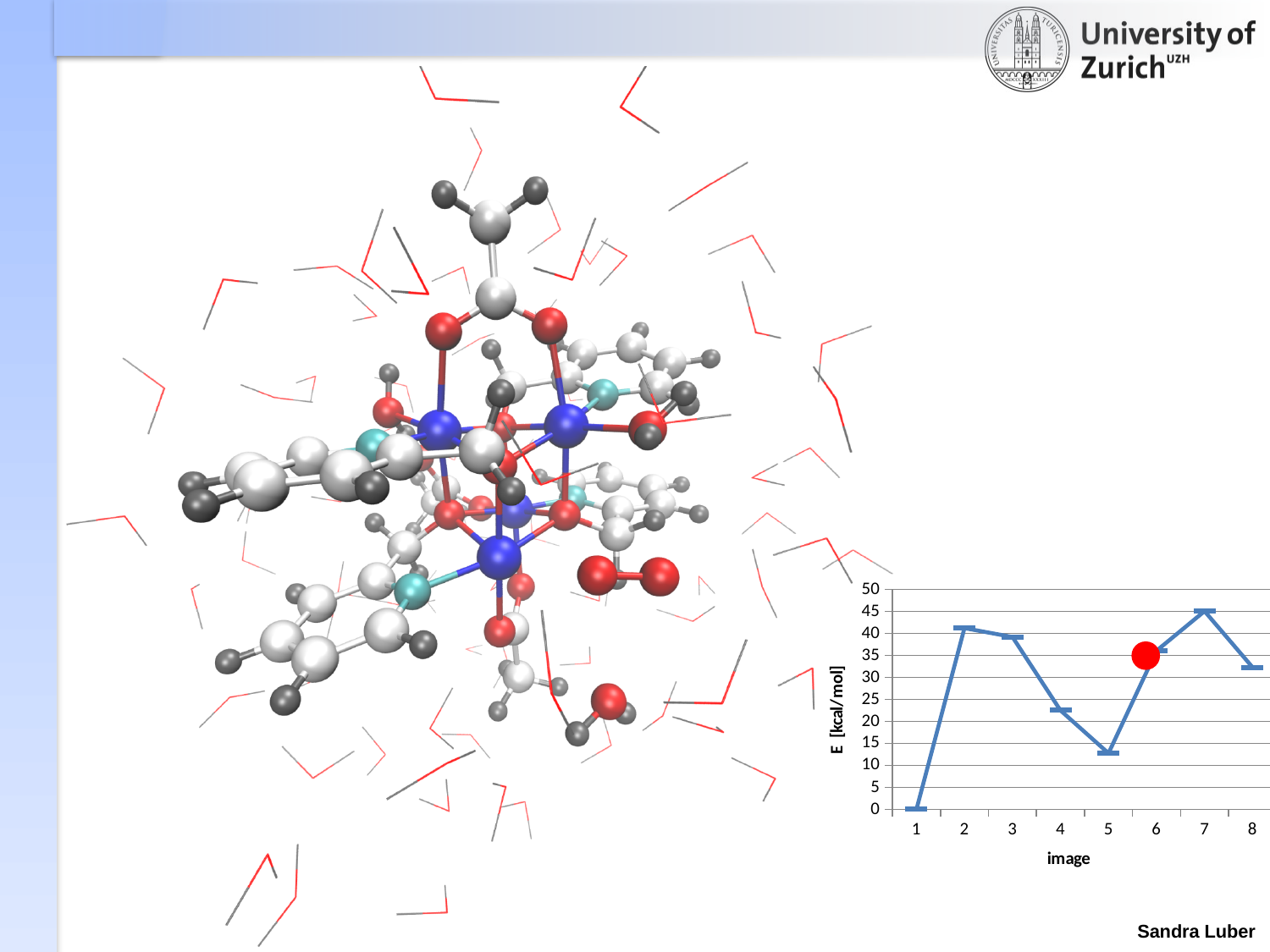
Which image number has the lowest energy value on the chart? 1 Is the value for image 5 greater or less than 15? less What kind of chart is shown on the slide? line chart How many data points are plotted on the line chart? 8 Do the values rise or fall from image 5 to image 7? rise Which has the larger energy value, image 2 or image 5? image 2 Which image number has the highest energy value on the chart? 7 What is the energy value for image 1? 0 Is the value for image 2 greater or less than 35? greater Do the values rise or fall from image 2 to image 5? fall Is the value for image 8 greater or less than 30? greater What is the label of the y axis on the chart? E [kcal/mol]